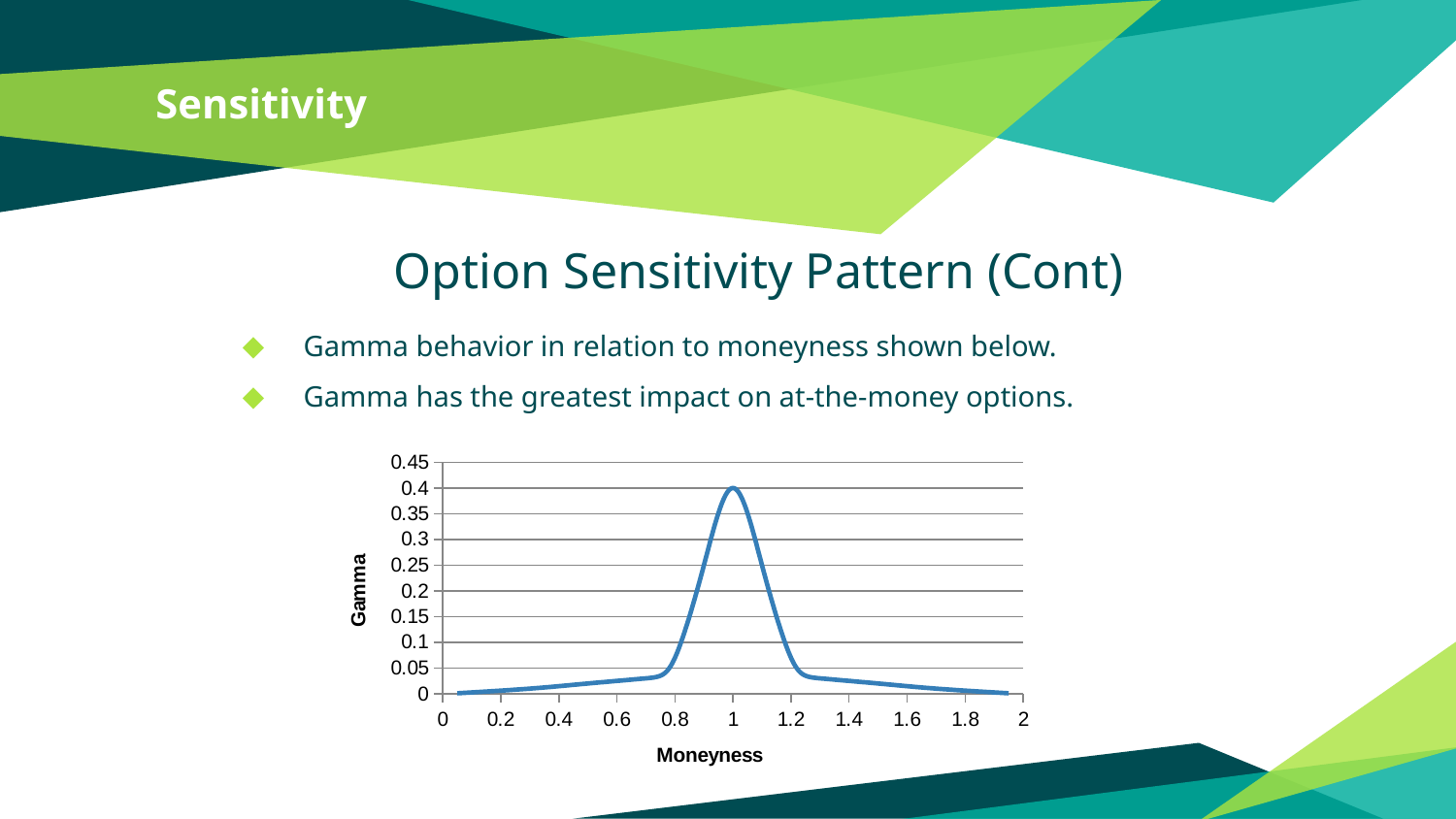
Is the gamma value at moneyness 0.4 greater or less than 0.05? less What kind of chart is shown on the slide? line chart What is the peak gamma value reached at moneyness 1? 0.4 What is the title of the y axis of the chart? Gamma Is the gamma value at moneyness 1.6 greater or less than 0.1? less Does gamma rise or fall as moneyness increases from 0 to 1? rise What is the title of the x axis of the chart? Moneyness Is the gamma value at moneyness 1 greater or less than 0.3? greater At which moneyness value does gamma reach its highest point? 1 Which has the larger gamma value: moneyness 1 or moneyness 0.2? moneyness 1 Does gamma rise or fall as moneyness increases from 1 to 2? fall